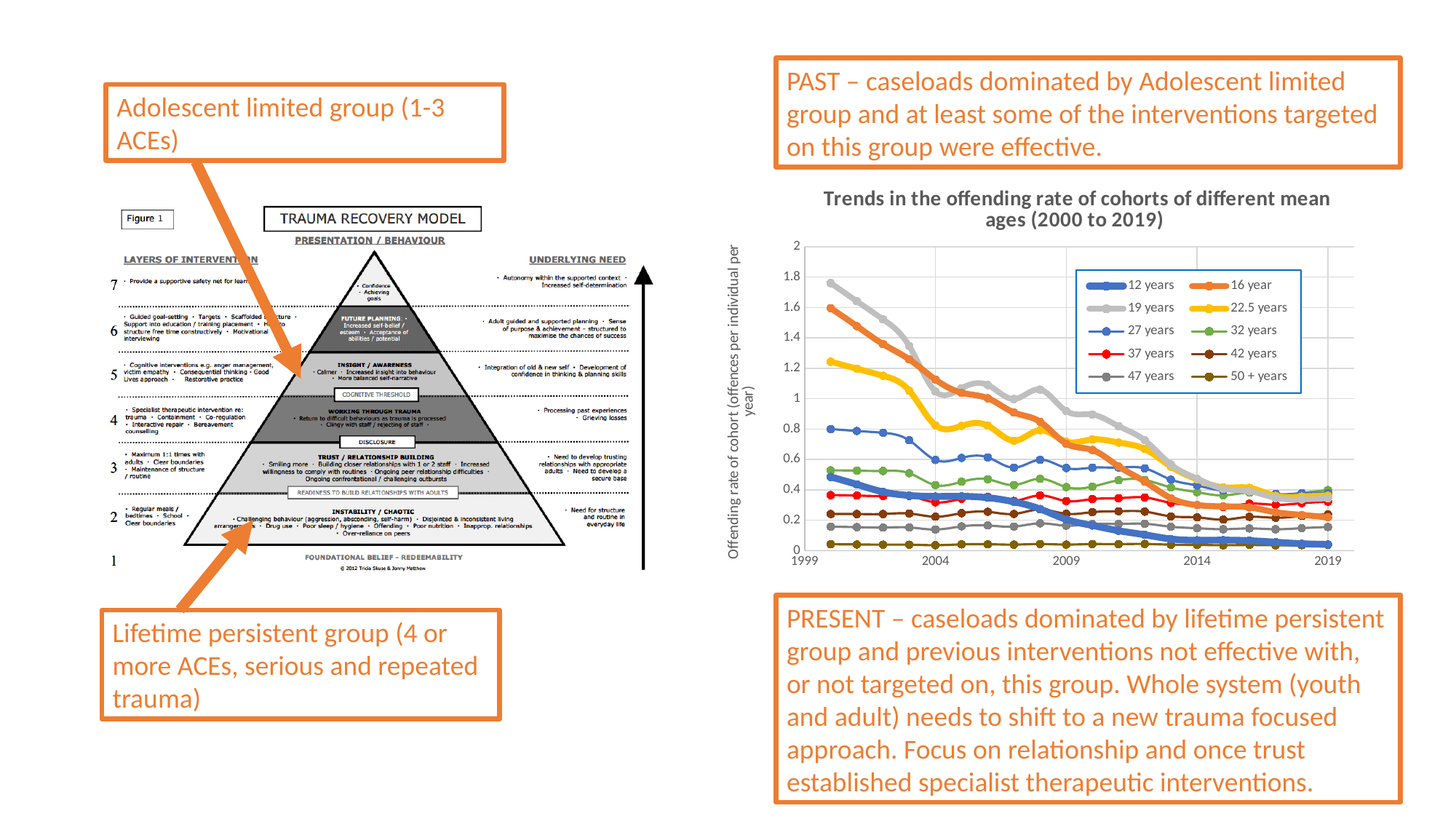
In the offending rate chart, which series has the highest value at the start of the period (around 2000)? 19 years In the offending rate chart, which series has the lowest values across the whole period? 50 + years What is the title of the line chart on the slide? Trends in the offending rate of cohorts of different mean ages (2000 to 2019) In the offending rate chart, is the value for the 22.5 years series around 2000 greater or less than 1? greater In the offending rate chart, which series is higher around 2000: 16 year or 27 years? 16 year What kind of chart is 'Trends in the offending rate of cohorts of different mean ages (2000 to 2019)'? line chart In the offending rate chart, is the value for the 12 years series in 2019 greater or less than 0.2? less In the offending rate chart, does the 16 year series rise or fall from 2000 to 2019? fall How many series does the legend of the offending rate chart list? 10 In the offending rate chart, does the 12 years series rise or fall over the period? fall In the offending rate chart, is the value for the 19 years series around 2000 greater or less than 1.6? greater What is the y-axis label of the offending rate chart? Offending rate of cohort (offences per individual per year)